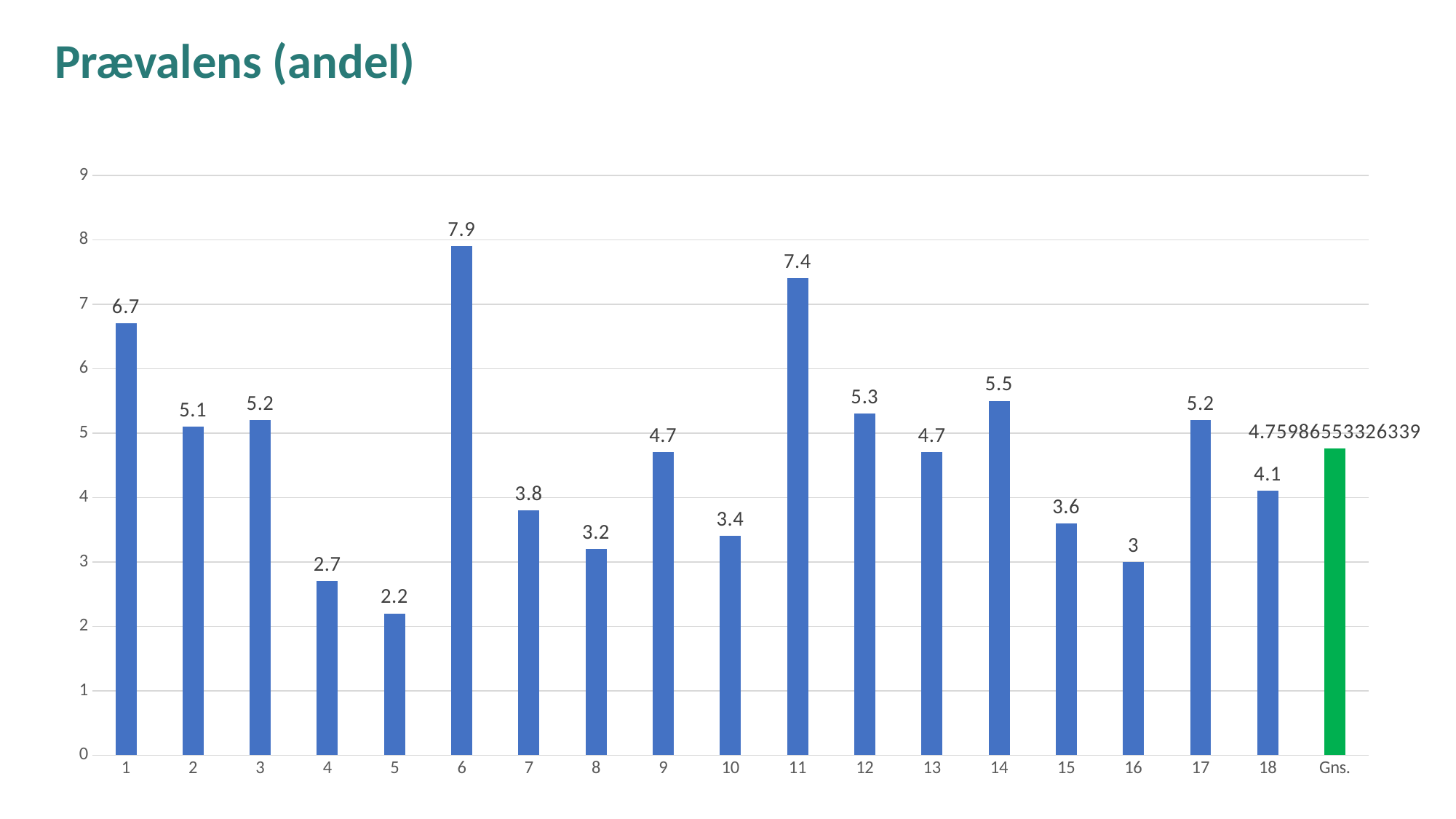
What kind of chart is shown on the slide? Bar chart How many bars are shown in the chart, including the Gns. bar? 19 What is the value for category 11? 7.4 What is the value for category 16? 3 Which bar is coloured green instead of blue? Gns. Which category has the lowest value? 5 Which is larger, the value for category 1 or the value for category 14? Category 1 What value is printed above the Gns. bar? 4.75986553326339 What is the title of the chart? Prævalens (andel) What is the difference between the values for category 6 and category 5? 5.7 What is the value for category 6? 7.9 Which category has the highest value? 6